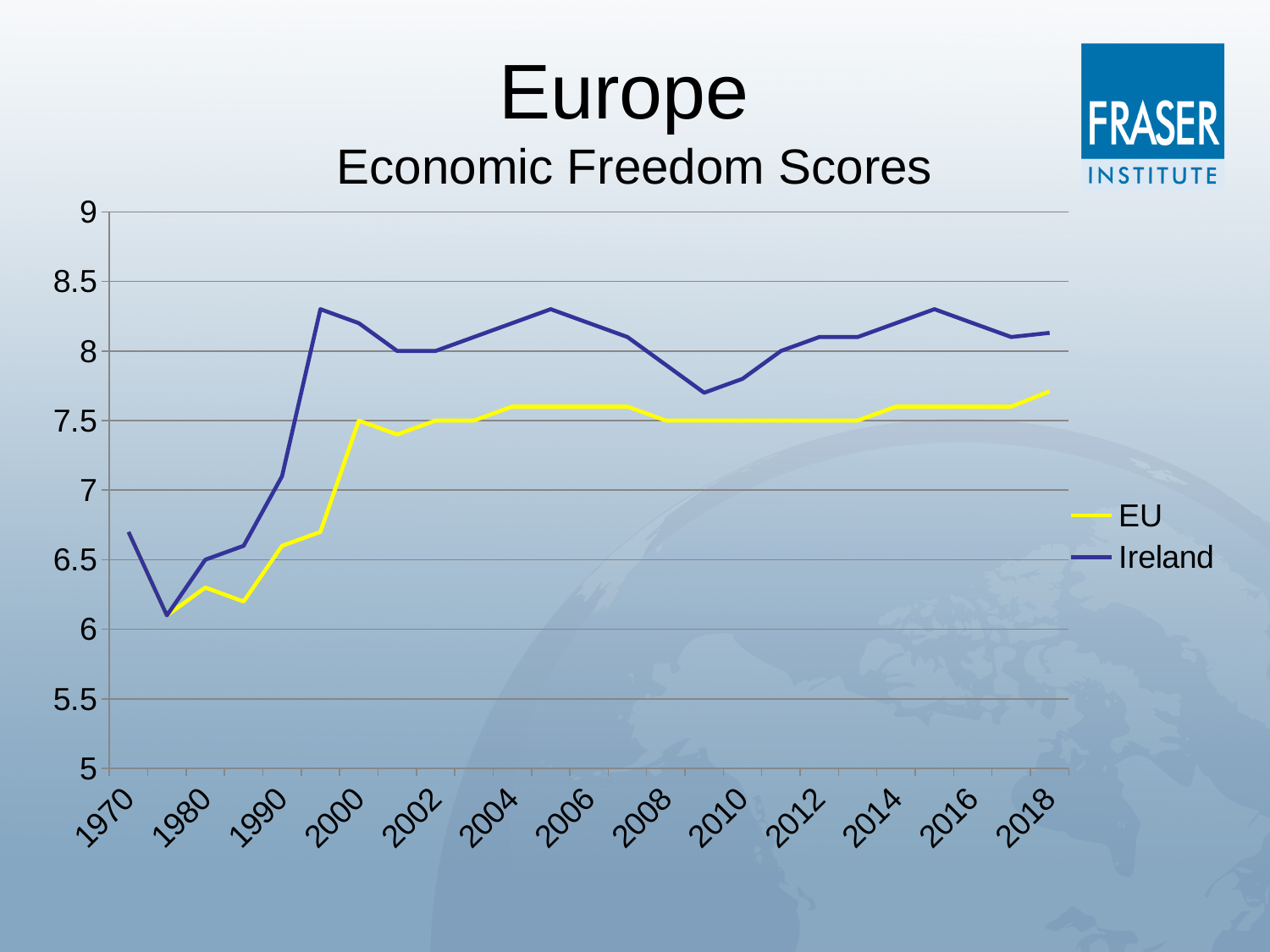
How many series does the legend list? 2 Which series has the higher value in 2000, EU or Ireland? Ireland Is the value for Ireland in 2018 greater or less than 8? greater Is the value for EU in 2018 greater or less than 8? less Does the EU line rise or fall overall from 1970 to 2018? rise What kind of chart is shown on the slide? line chart Which two series are shown in the legend? EU and Ireland What colour is the line for Ireland? blue Which series has the higher value in 2018, EU or Ireland? Ireland Is the value for Ireland in 2010 greater or less than 8? less